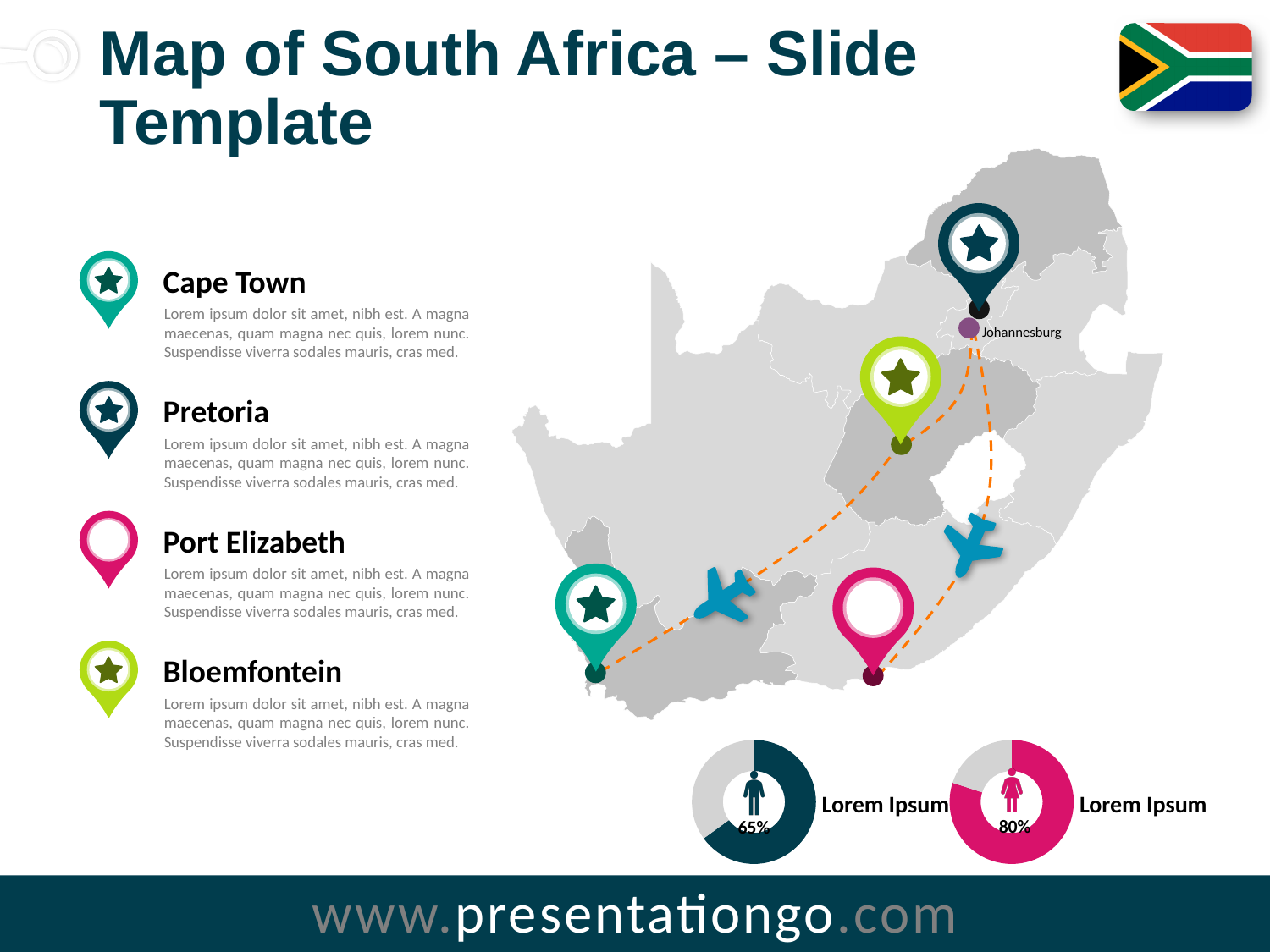
What colour is the filled portion of the donut chart showing 80%? pink What label appears next to each of the two donut charts at the bottom of the slide? Lorem Ipsum How many donut charts are shown at the bottom of the slide? 2 What kind of chart is used at the bottom of the slide to show the 65% and 80% values? donut chart What value is shown on the left donut chart at the bottom of the slide? 65% Is the value shown on the right donut chart greater or less than 75%? greater Which of the two donut charts at the bottom of the slide shows the larger value, the left one or the right one? the right one What is the difference between the values shown on the right and left donut charts at the bottom of the slide? 15% Is the value shown on the left donut chart greater or less than 50%? greater What value is shown on the right donut chart at the bottom of the slide? 80%